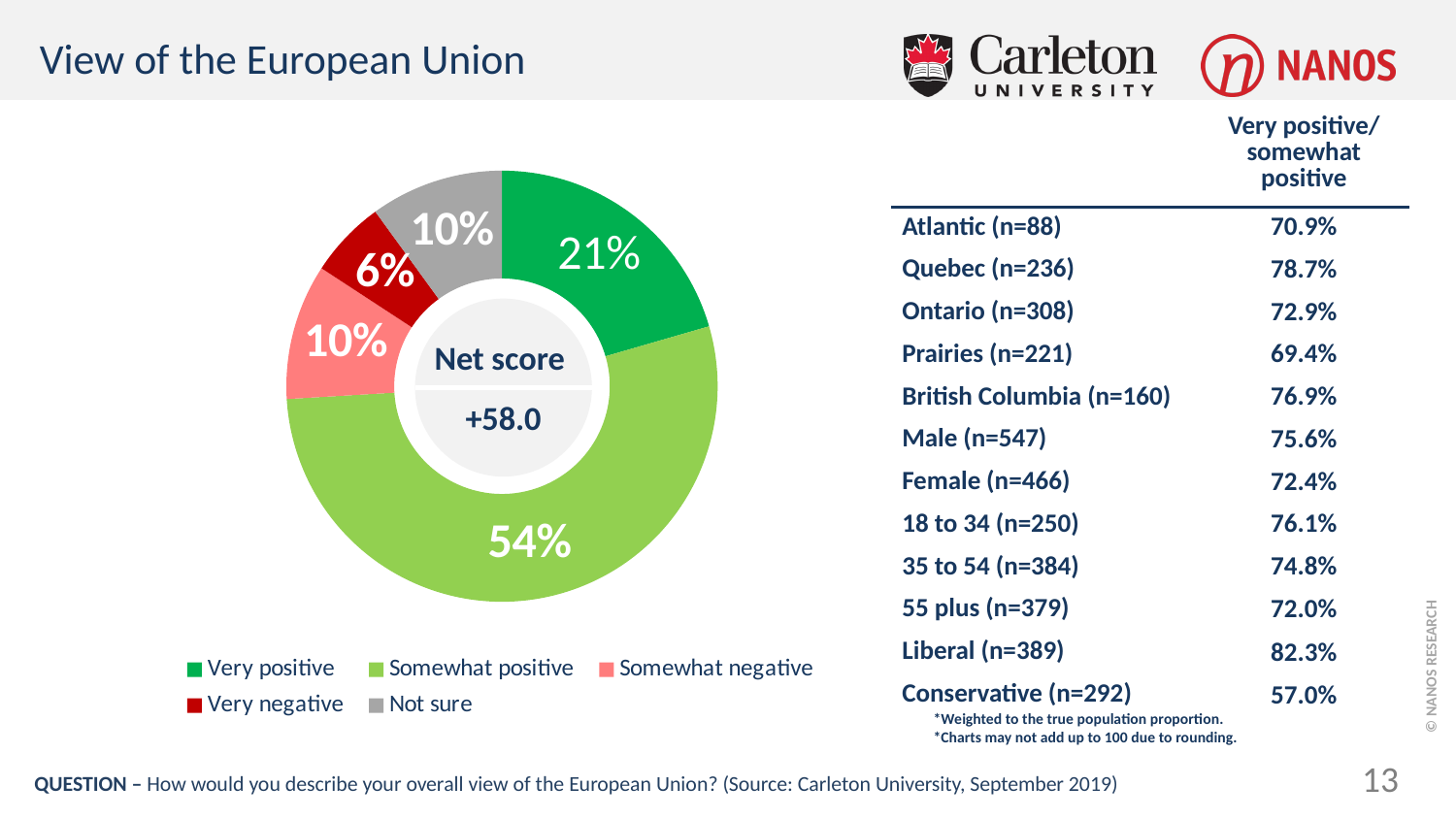
What net score is shown in the centre of the donut chart? +58.0 What percentage of respondents have a very negative view of the European Union? 6% Which response category has the smallest share of the pie? Very negative Which response category has the largest share of the pie? Somewhat positive Which is larger, the very positive slice or the somewhat negative slice? Very positive What percentage of respondents are not sure about their view of the European Union? 10% How many response categories does the legend list? 5 What is the difference in percentage points between the somewhat positive and very positive slices? 33 What kind of chart is shown on the slide? Pie chart (donut) What percentage of respondents have a very positive view of the European Union? 21% What percentage of respondents have a somewhat positive view of the European Union? 54% What colour is the somewhat negative slice in the chart? Light red (pink)